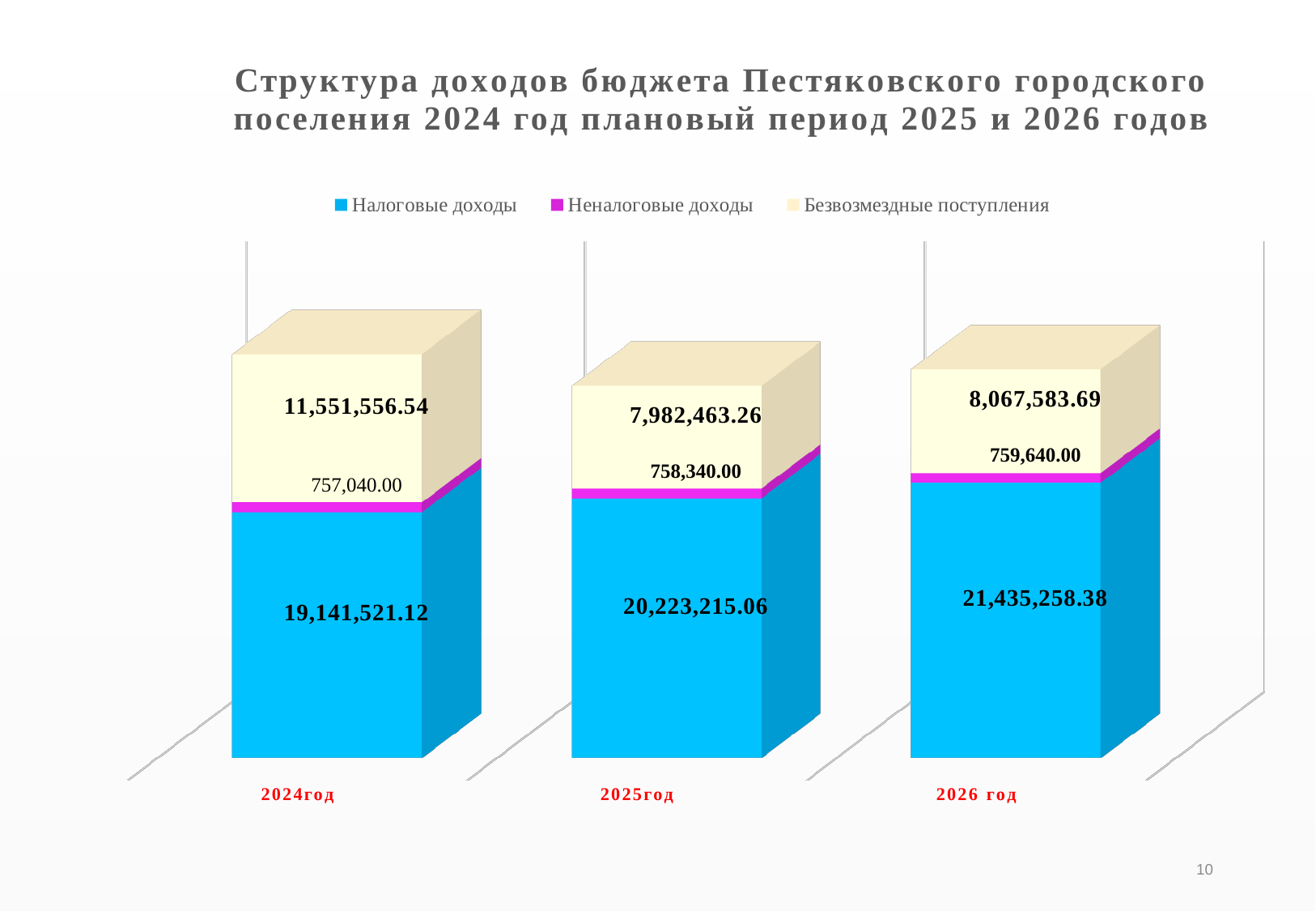
What is the total of the stacked bar for 2025год? 28,964,018.32 Which is larger: Безвозмездные поступления in 2024год or in 2026 год? 2024год What kind of chart is shown on the slide? Stacked bar chart How many years (categories) are shown on the x axis? 3 In which year is the value of Безвозмездные поступления the lowest? 2025год What is the difference between Налоговые доходы in 2026 год and in 2024год? 2,293,737.26 What is the value of Безвозмездные поступления for 2025год? 7,982,463.26 What is the value of Налоговые доходы for 2024год? 19,141,521.12 What is the value of Неналоговые доходы for 2026 год? 759,640.00 Do the values of Налоговые доходы rise or fall from 2024год to 2026 год? Rise How many series does the legend list? 3 In which year is the value of Налоговые доходы the highest? 2026 год